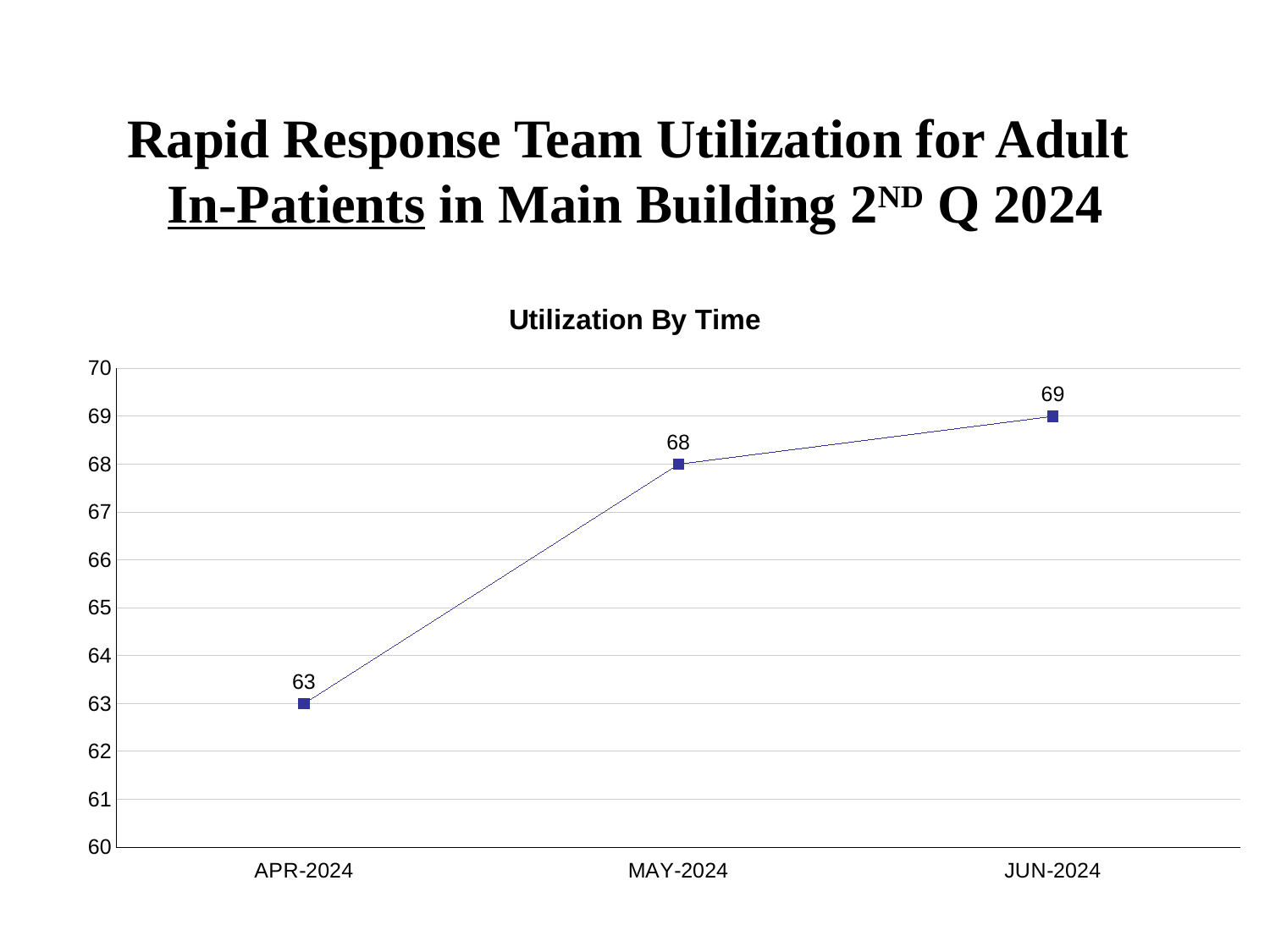
What is the difference between the values for JUN-2024 and MAY-2024? 1 Which month has the lowest value? APR-2024 What is the value for APR-2024? 63 Which month has the highest value? JUN-2024 What kind of chart is shown on the slide? line chart What is the value for MAY-2024? 68 Is the value for APR-2024 greater or less than 65? less What is the value for JUN-2024? 69 What is the difference between the values for MAY-2024 and APR-2024? 5 Do the values rise or fall from APR-2024 to JUN-2024? rise Which is larger, the value for APR-2024 or the value for MAY-2024? MAY-2024 How many months are plotted on the chart? 3